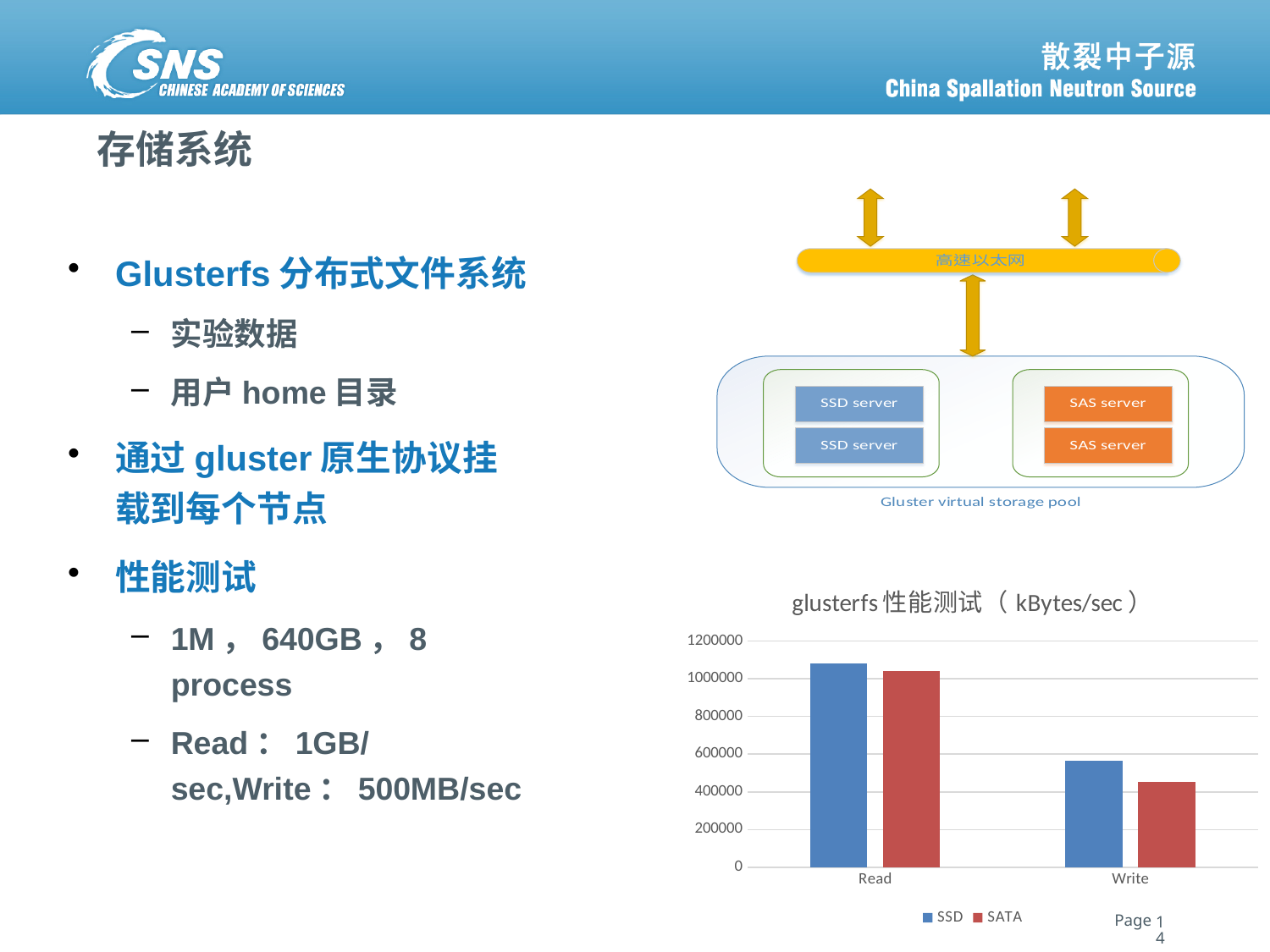
Is the SSD value for Write greater or less than 600000? less Is the SATA value for Write greater or less than 600000? less Is the SATA value for Write greater or less than 400000? greater How many series does the chart's legend list? 2 For Write, which series has the larger value, SSD or SATA? SSD Which series is shown in blue in the chart? SSD For the SSD series, which category has the larger value, Read or Write? Read How many categories are shown on the x axis of the chart? 2 Which category and series combination has the lowest bar in the chart? Write, SATA What is the title of the chart on the slide? glusterfs 性能测试（kBytes/sec） What kind of chart is shown at the bottom right of the slide? bar chart